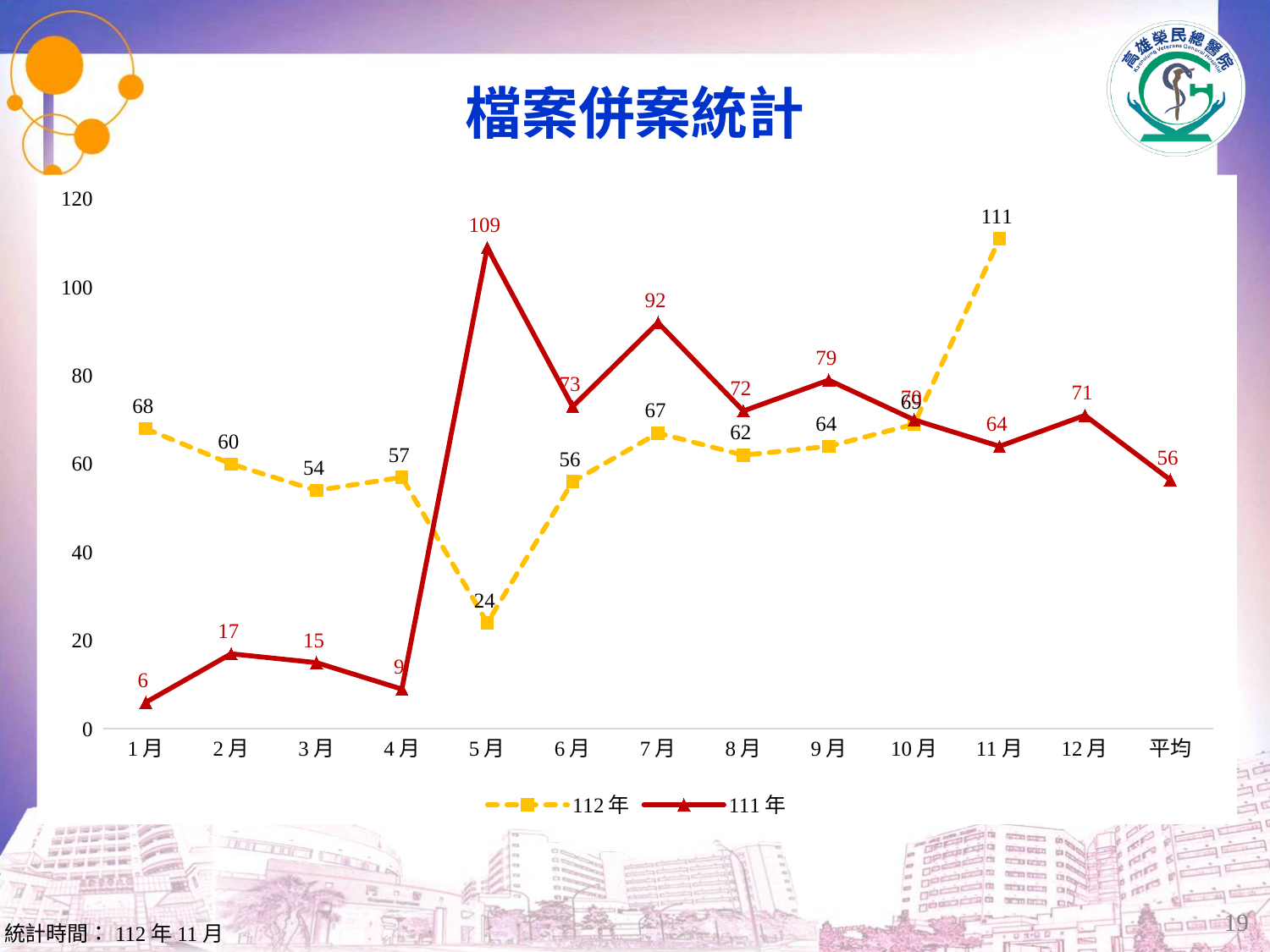
What is the difference between the 111年 and 112年 values in 5月? 85 What is the value for 111年 in 5月? 109 How many categories are shown on the x axis? 13 Does the 112年 series rise or fall from 1月 to 3月? fall What is the 平均 value for 111年? 56 What is the title of the chart? 檔案併案統計 In which month does the 112年 series reach its highest value? 11月 In 7月, which series has the larger value, 112年 or 111年? 111年 How many series does the legend list? 2 What is the value for 112年 in 5月? 24 In which month does the 111年 series have its lowest value? 1月 What kind of chart is shown on the slide? line chart